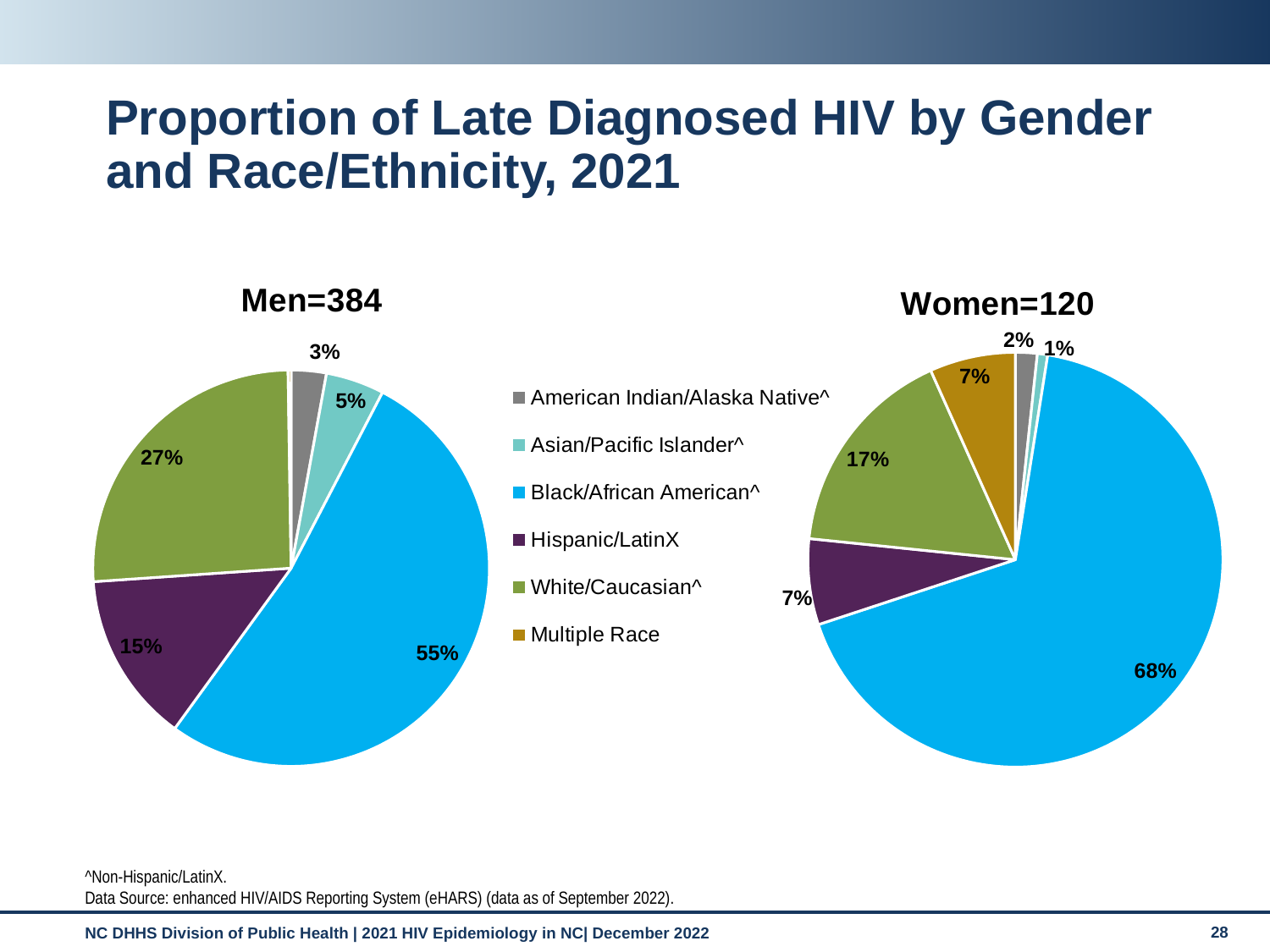
Is the White/Caucasian^ share larger in the Men=384 chart or the Women=120 chart? Men=384 What kind of charts are shown on the slide? Pie charts In the Women=120 chart, which race/ethnicity has the smallest slice? Asian/Pacific Islander^ In the Women=120 chart, what share is Multiple Race? 7% In the Men=384 chart, which race/ethnicity has the smallest labelled slice? American Indian/Alaska Native^ What is the difference between the Black/African American^ share in the Women=120 chart and in the Men=384 chart? 13% How many race/ethnicity categories does the legend list? 6 In the Women=120 chart, which race/ethnicity has the largest slice? Black/African American^ In the Men=384 chart, what share is Hispanic/LatinX? 15% In the Women=120 chart, what share is White/Caucasian^? 17% In the Men=384 chart, what share is Black/African American^? 55% What colour represents Hispanic/LatinX in the legend? Purple